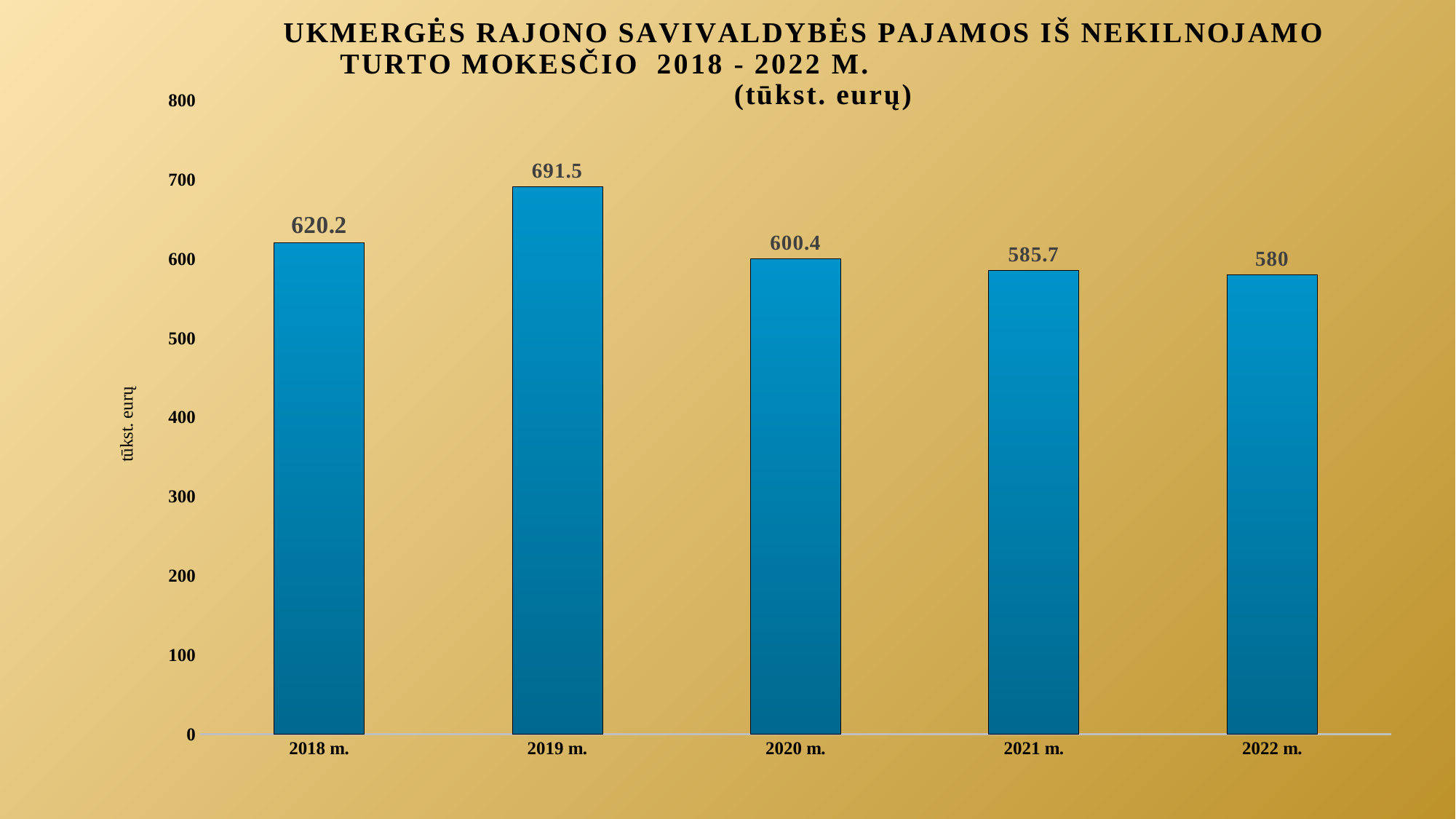
What is the difference between the values for 2019 m. and 2018 m.? 71.3 What kind of chart is this? bar chart What is the value for 2019 m.? 691.5 What is the value for 2022 m.? 580 Which year has the lowest value? 2022 m. Which year has the highest value? 2019 m. What is the value for 2020 m.? 600.4 Which is larger, the value for 2018 m. or the value for 2020 m.? 2018 m. Is the value for 2021 m. greater or less than 500? greater How many years are shown on the x axis? 5 What is the difference between the values for 2021 m. and 2022 m.? 5.7 Do the values rise or fall from 2019 m. to 2022 m.? fall